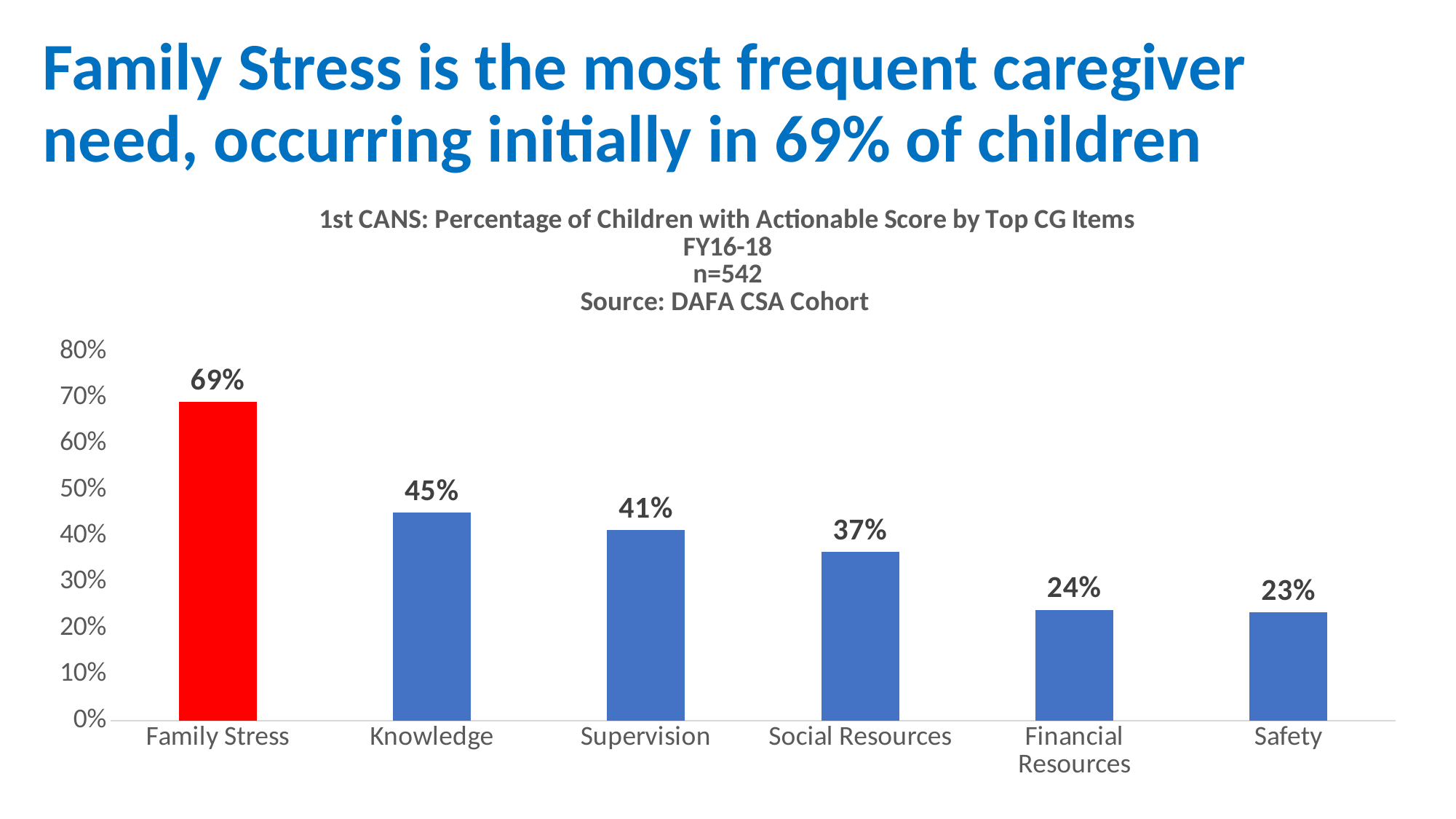
What is the value for Financial Resources? 24% What is the difference between the values for Family Stress and Knowledge? 24% What is the value for Family Stress? 69% What kind of chart is shown on the slide? bar chart Which category has the lowest value? Safety Is the value for Supervision greater or less than 50%? less How many categories are shown on the chart? 6 What is the difference between the values for Social Resources and Safety? 14% What is the value for Supervision? 41% Which bar is coloured red? Family Stress Which category has the highest value? Family Stress Which is larger, the value for Knowledge or the value for Social Resources? Knowledge